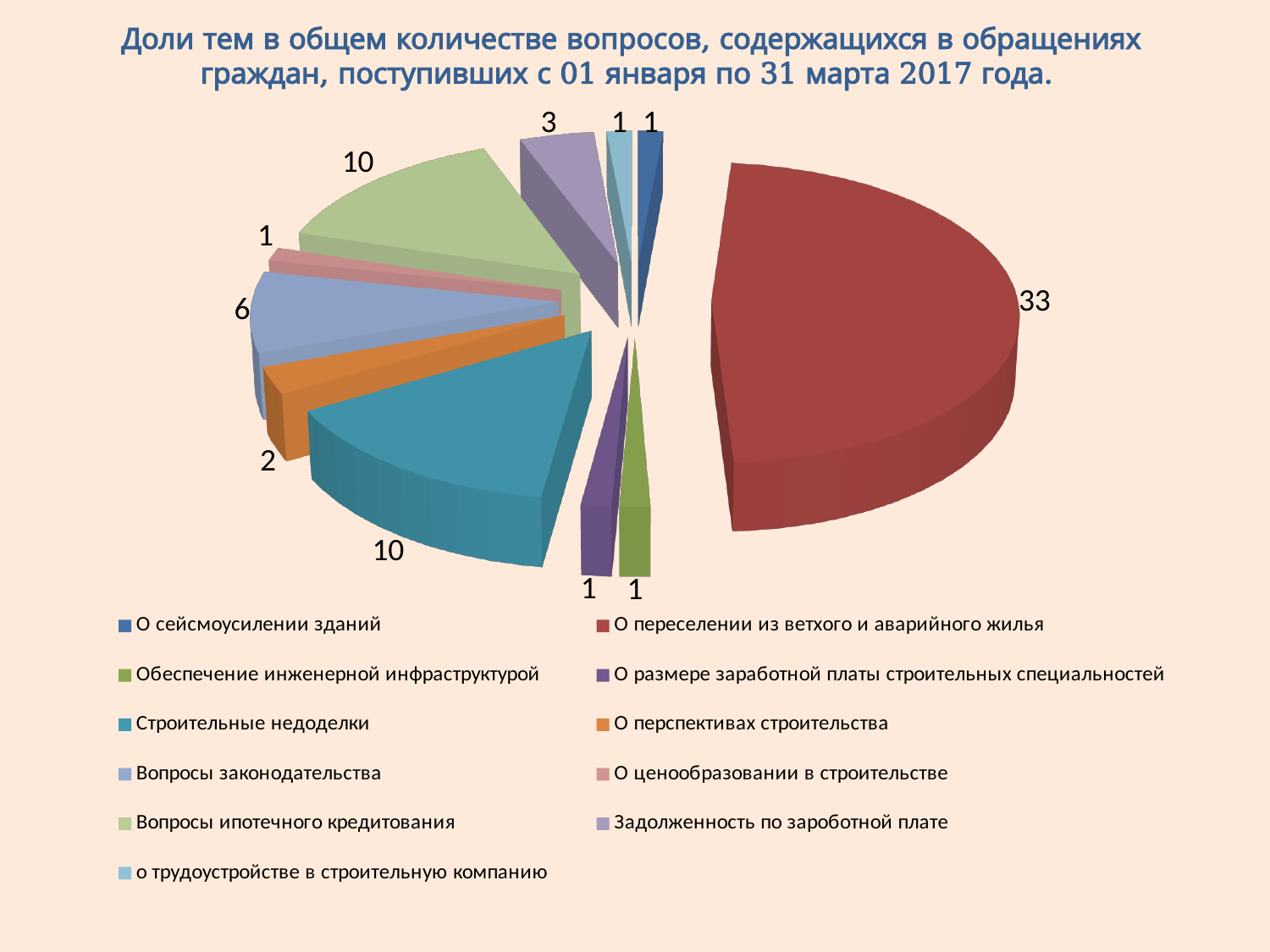
What kind of chart is shown on the slide? Pie chart What is the difference between the values for "О переселении из ветхого и аварийного жилья" and "Строительные недоделки"? 23 What value is shown for the slice "О перспективах строительства"? 2 What value is shown for the slice "Вопросы законодательства"? 6 What value is shown for the slice "Строительные недоделки"? 10 What value is shown for the slice "Задолженность по заработной плате"? 3 How many categories does the legend list? 11 What is the difference between the values for "Вопросы законодательства" and "О перспективах строительства"? 4 What value is shown for the slice "О переселении из ветхого и аварийного жилья"? 33 Which is larger: the value for "Строительные недоделки" or for "Вопросы законодательства"? Строительные недоделки Which category has the largest slice of the pie? О переселении из ветхого и аварийного жилья What period does the chart title say the citizens' appeals were received in? с 01 января по 31 марта 2017 года